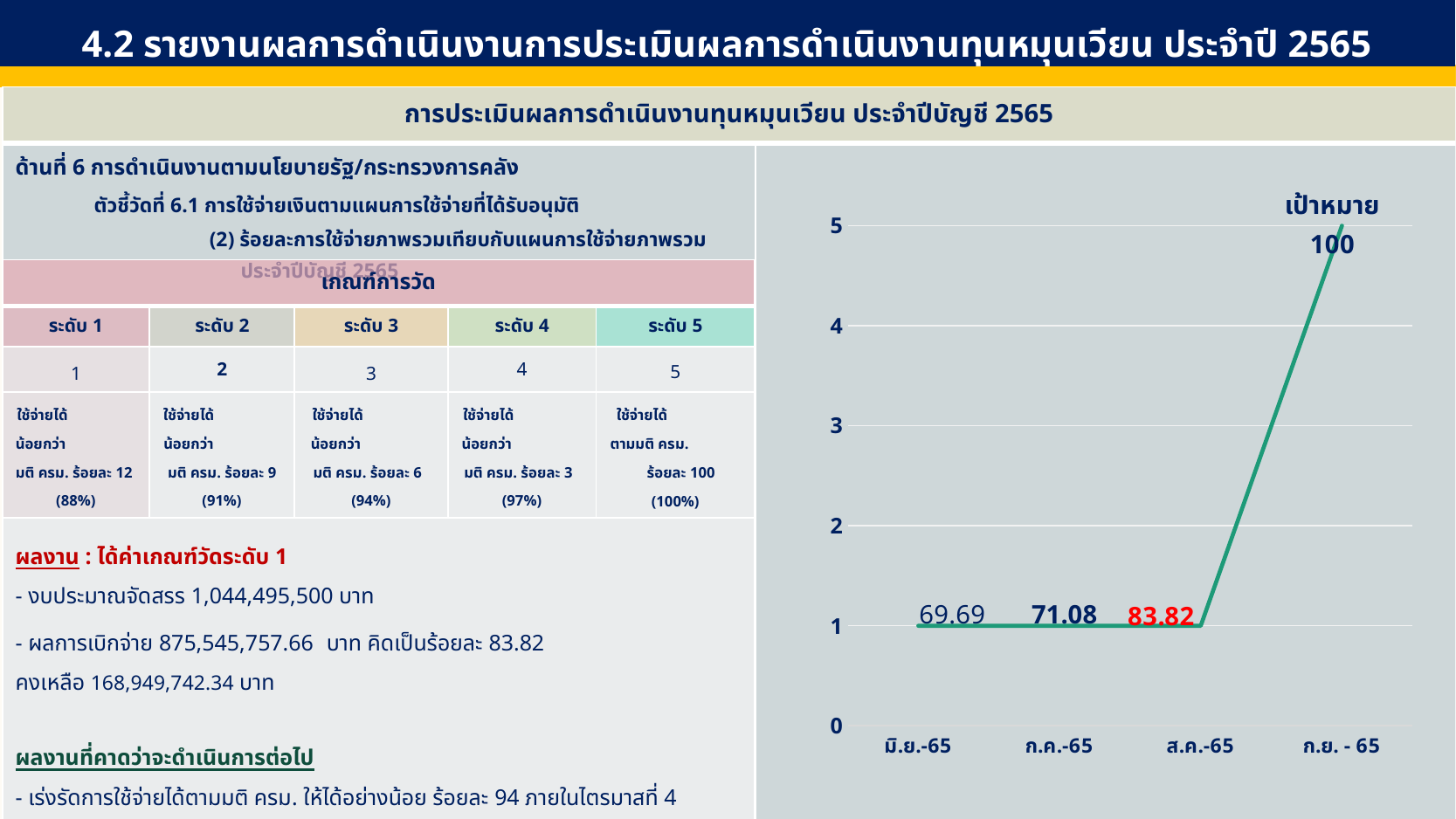
What data label is shown for มิ.ย.-65 on the line chart? 69.69 Do the data labels on the line chart rise or fall from มิ.ย.-65 to ก.ย. - 65? rise What value is shown for the target (เป้าหมาย) at ก.ย. - 65 on the line chart? 100 Which data label is larger on the line chart, ก.ค.-65 or ส.ค.-65? ส.ค.-65 Is the plotted level for ก.ย. - 65 greater or less than 4? greater Is the plotted level for ส.ค.-65 greater or less than 2? less What data label is shown for ส.ค.-65 on the line chart? 83.82 How many months are shown on the x axis of the line chart? 4 What data label is shown for ก.ค.-65 on the line chart? 71.08 What kind of chart is shown on the right side of the slide? line chart What is the highest tick value shown on the y axis of the line chart? 5 Which month on the line chart has the highest plotted level? ก.ย. - 65